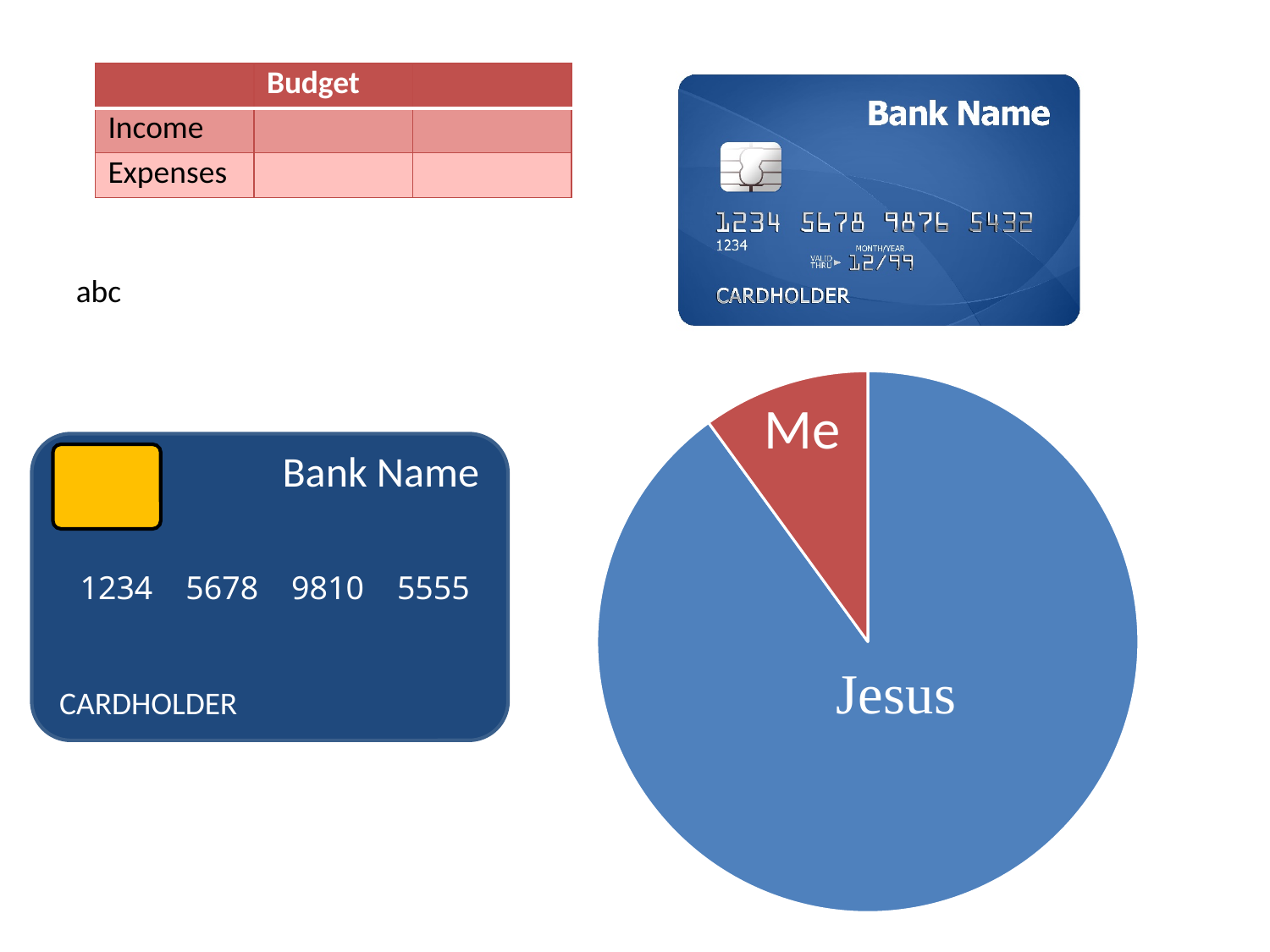
What kind of chart is shown on the slide? pie chart What colour is the Jesus slice in the pie chart? blue What colour is the Me slice in the pie chart? red Which slice of the pie chart is the largest? Jesus In the pie chart, which slice is larger, Me or Jesus? Jesus How many slices does the pie chart have? 2 Which slice of the pie chart is the smallest? Me